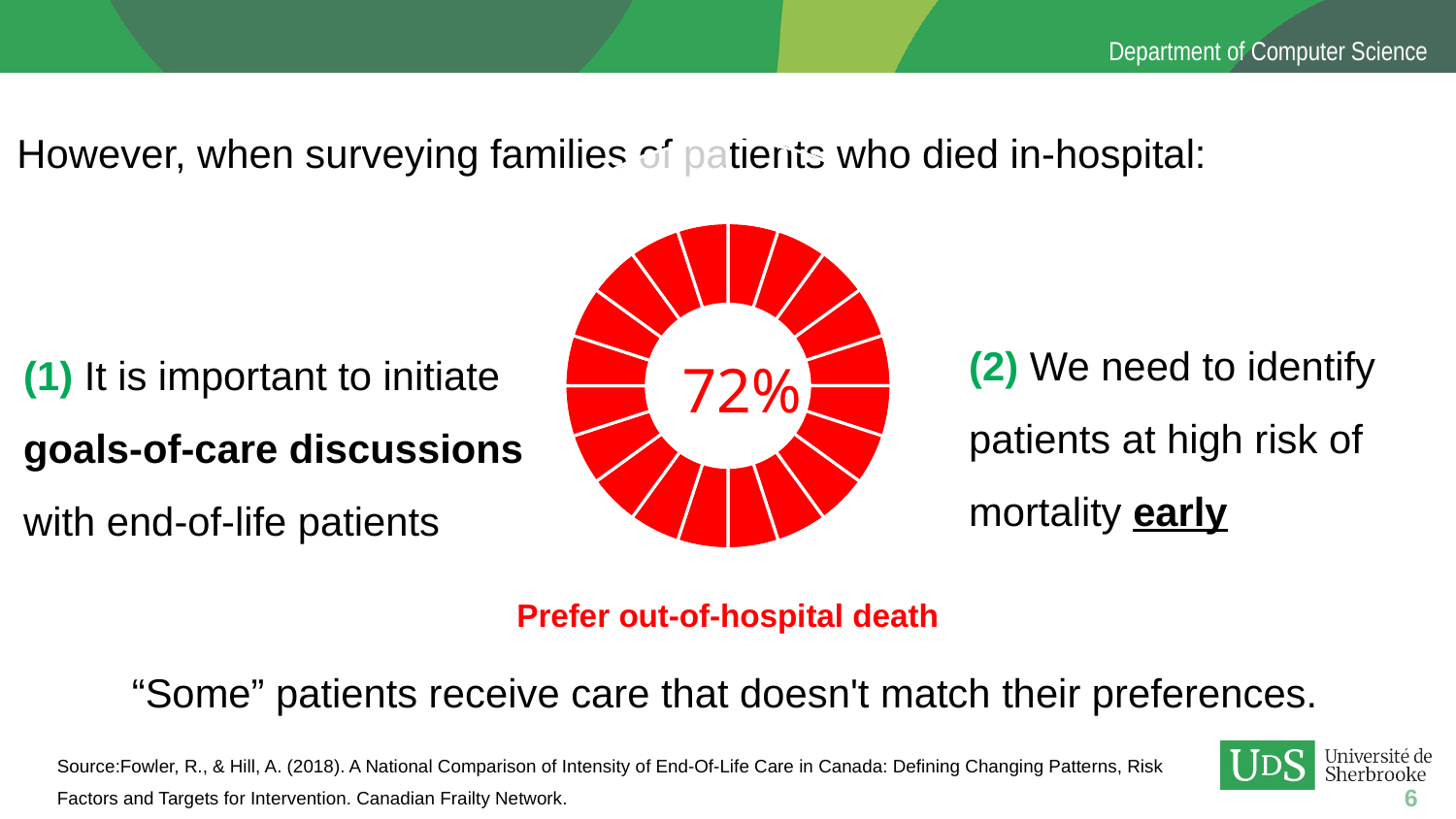
Is the value shown in the ring chart greater or less than 50%? greater What percentage is shown in the centre of the ring chart? 72% What caption appears directly below the ring chart? Prefer out-of-hospital death What kind of chart is used to display the 72% figure? Doughnut (ring) chart What colour are the segments of the ring chart? Red What share of surveyed families prefer out-of-hospital death, according to the chart? 72%